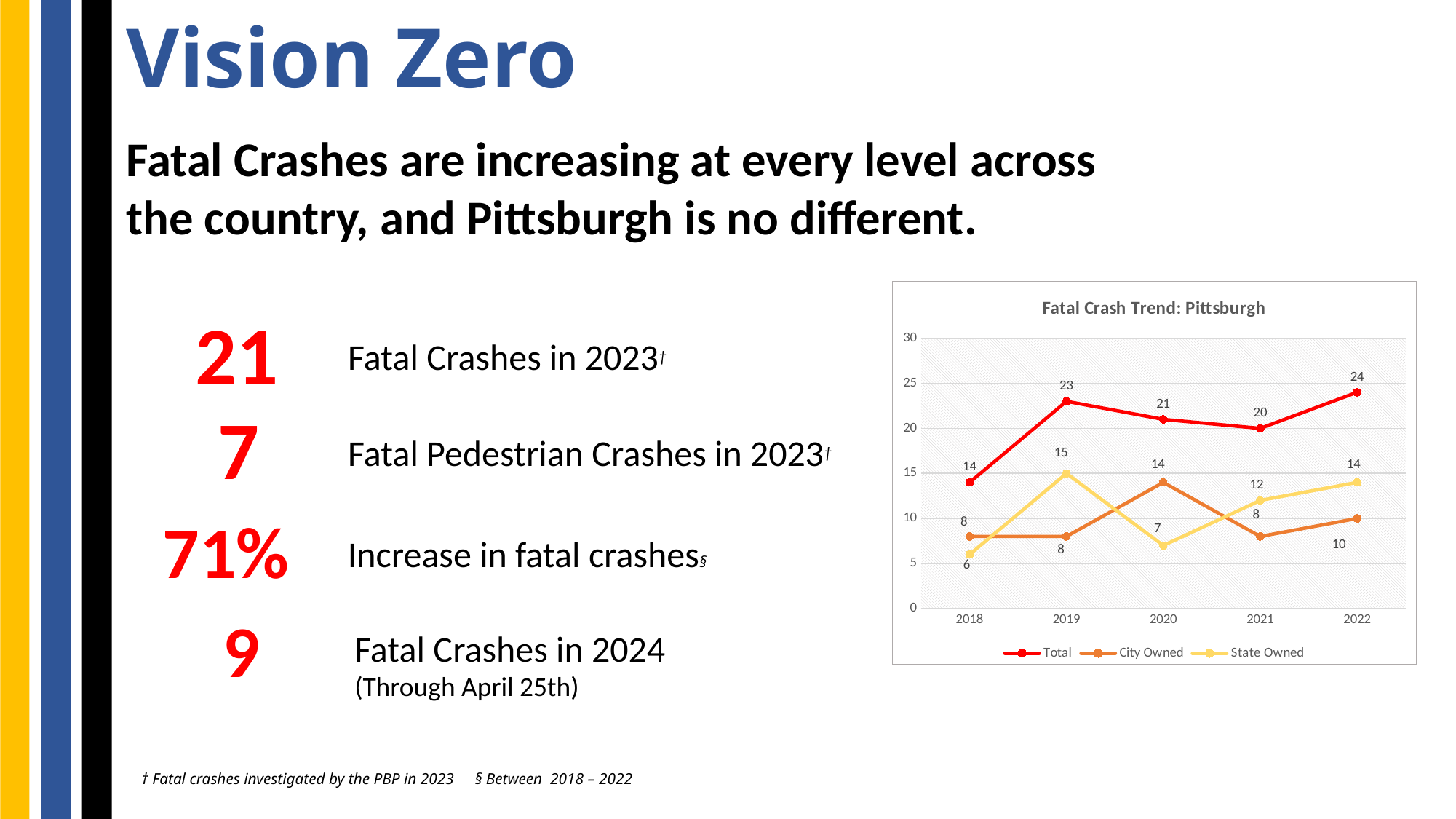
How many years are plotted on the x axis of the chart? 5 What is the Total value for 2019? 23 Is the Total value for 2020 greater or less than 15? greater What is the title of the chart? Fatal Crash Trend: Pittsburgh How many series does the chart's legend list? 3 What is the City Owned value for 2020? 14 In which year is the Total series highest? 2022 What is the difference between the Total values for 2022 and 2018? 10 In which year is the Total series lowest? 2018 In 2021, which is larger: City Owned or State Owned? State Owned What is the State Owned value for 2018? 6 What type of chart is shown on the slide? line chart